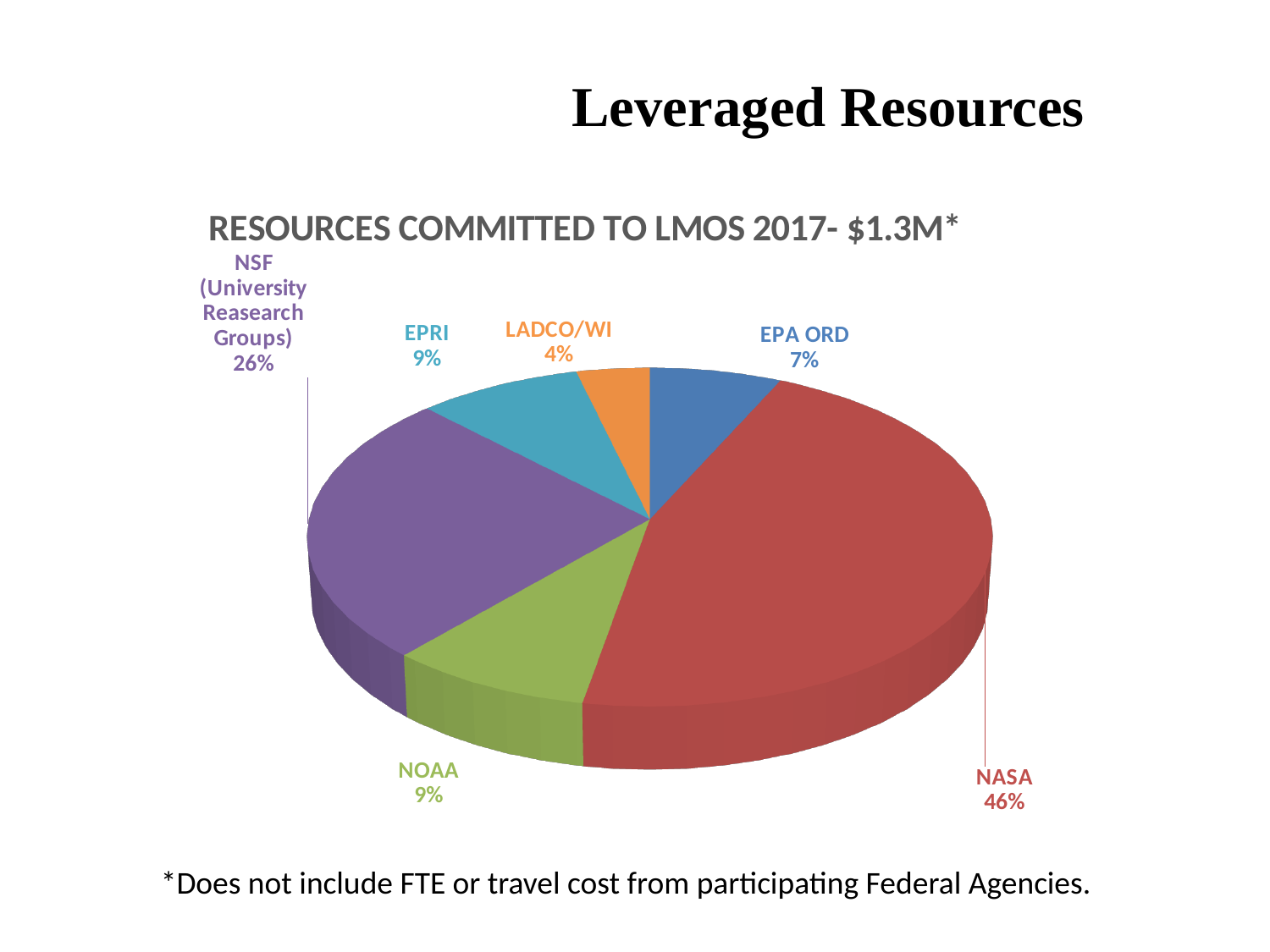
What is the title of the chart? RESOURCES COMMITTED TO LMOS 2017- $1.3M* What percentage is shown for NSF (University Reasearch Groups)? 26% What percentage is shown for EPA ORD? 7% What percentage is shown for LADCO/WI? 4% What kind of chart is shown on the slide? Pie chart How many categories are shown in the pie chart? 6 What colour is the NOAA slice? Green What share of the pie does NASA account for? 46% Which is larger, the share for EPA ORD or the share for EPRI? EPRI What is the difference in percentage points between NASA and NSF (University Reasearch Groups)? 20 Which category has the smallest slice of the pie? LADCO/WI Which category has the largest slice of the pie? NASA